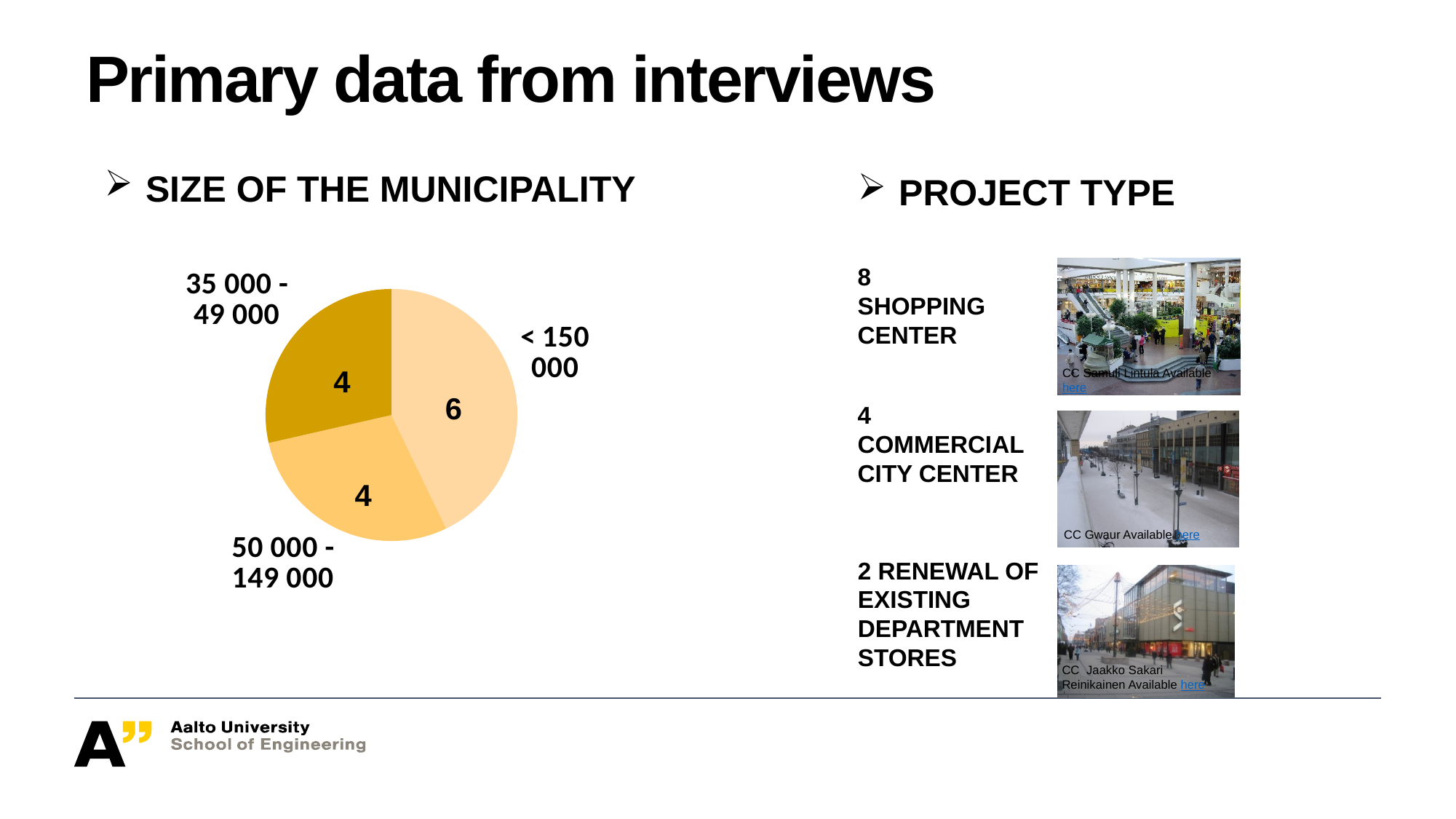
What is the value of the "< 150 000" slice in the pie chart? 6 What is the value of the "35 000 - 49 000" slice in the pie chart? 4 What heading appears above the pie chart? SIZE OF THE MUNICIPALITY What is the difference between the "< 150 000" slice and the "50 000 - 149 000" slice in the pie chart? 2 What is the value of the "50 000 - 149 000" slice in the pie chart? 4 What is the total of all slice values in the pie chart? 14 Which slice of the pie chart is the darkest shade? 35 000 - 49 000 Which of the two is larger in the pie chart: "< 150 000" or "35 000 - 49 000"? < 150 000 Which two municipality size categories have equal values in the pie chart? 35 000 - 49 000 and 50 000 - 149 000 Which municipality size category has the largest slice in the pie chart? < 150 000 How many slices does the pie chart have? 3 What type of chart is shown under "Size of the municipality"? Pie chart